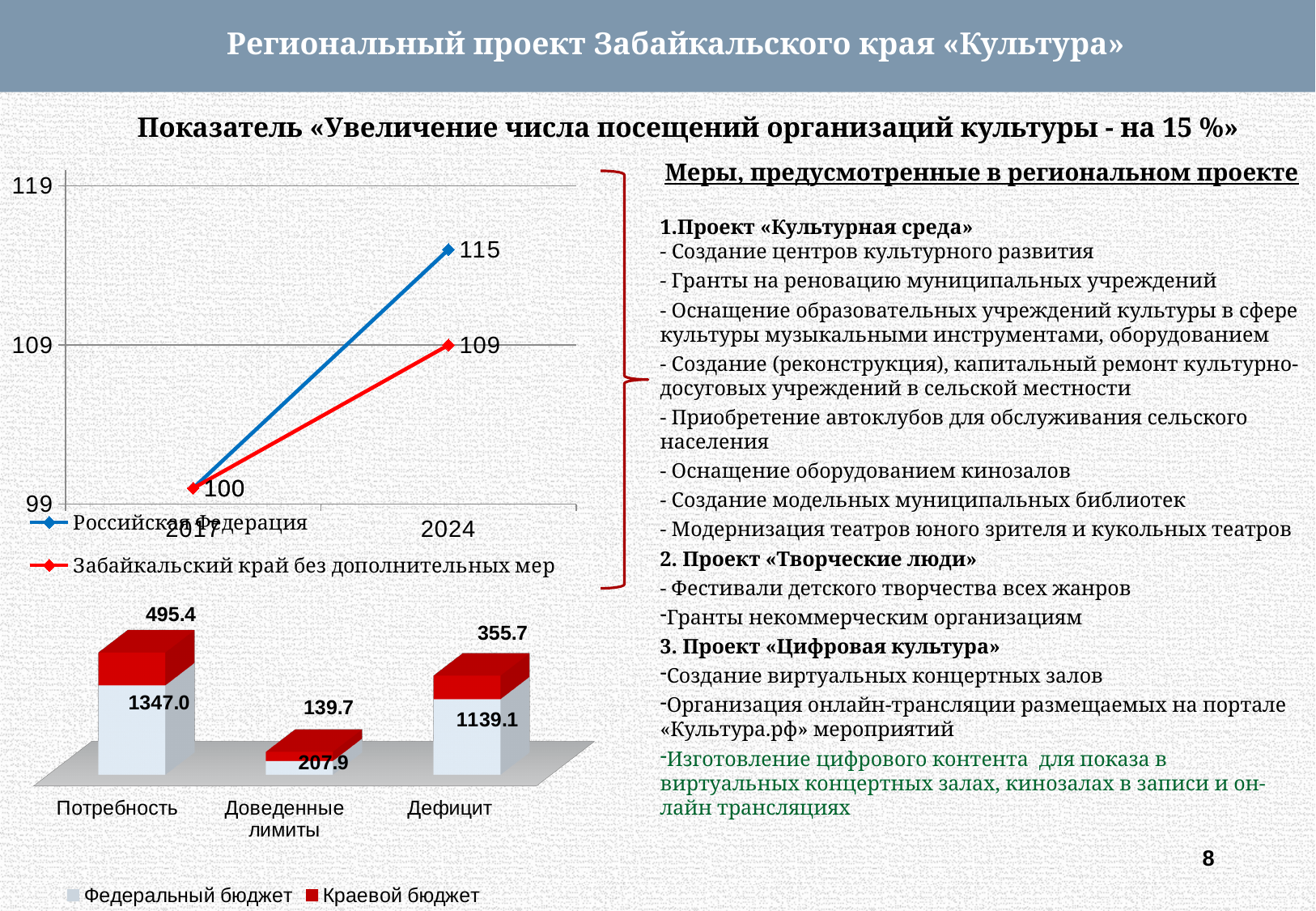
In the bottom bar chart, which is larger: the Федеральный бюджет value for Дефицит or for Доведенные лимиты? Дефицит In the top line chart, what is the value for Забайкальский край без дополнительных мер in 2024? 109 In the top line chart, what is the value for Российская Федерация in 2024? 115 In the bottom bar chart, what is the total of the Доведенные лимиты bar? 347.6 In the bottom bar chart, what is the Федеральный бюджет value for Потребность? 1347.0 In the bottom bar chart, which category has the lowest Краевой бюджет value? Доведенные лимиты What kind of chart is the top chart on the slide? line chart In the top line chart, what is the difference between the 2024 values of Российская Федерация and Забайкальский край без дополнительных мер? 6 In the bottom bar chart, what is the Краевой бюджет value for Дефицит? 355.7 In the top line chart, do the values rise or fall from 2017 to 2024? rise How many series does the legend of the top line chart list? 2 How many categories are shown on the x axis of the bottom bar chart? 3